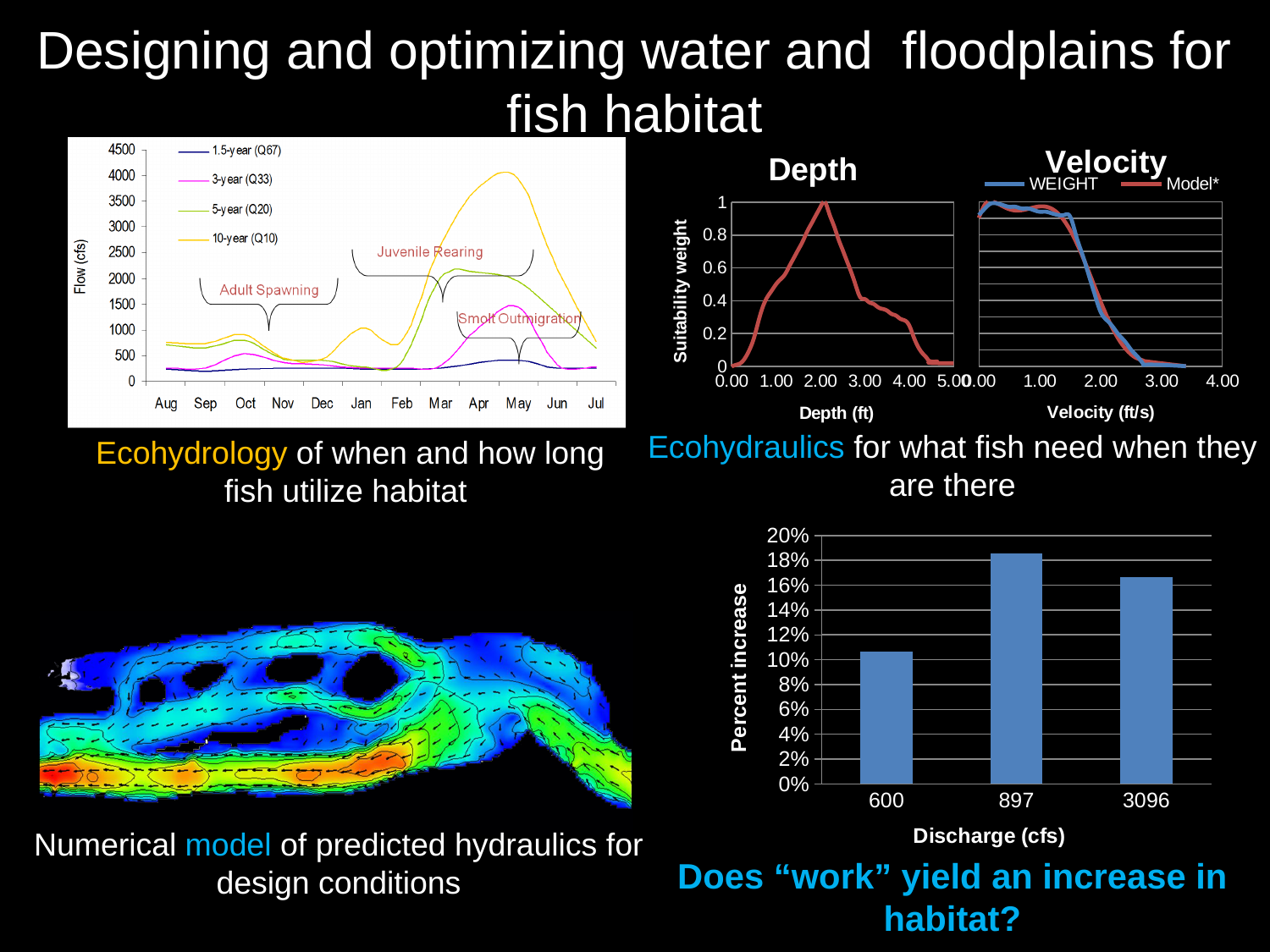
How many discharge categories are shown in the bottom-right bar chart? 3 What is the x-axis title of the bottom-right bar chart? Discharge (cfs) In the bottom-right bar chart, is the percent increase for 3096 cfs greater or less than 14%? greater How many series does the legend of the top-left flow chart list? 4 What kind of chart is the bottom-right chart showing percent increase by discharge? bar chart How many series does the legend above the Velocity chart list? 2 In the bottom-right bar chart, is the percent increase for 897 cfs greater or less than 16%? greater In the bottom-right bar chart, is the percent increase for 600 cfs greater or less than 12%? less In the bottom-right bar chart, which discharge has the highest percent increase? 897 In the bottom-right bar chart, which discharge has the lowest percent increase? 600 In the bottom-right bar chart, which has the larger percent increase, 897 cfs or 3096 cfs? 897